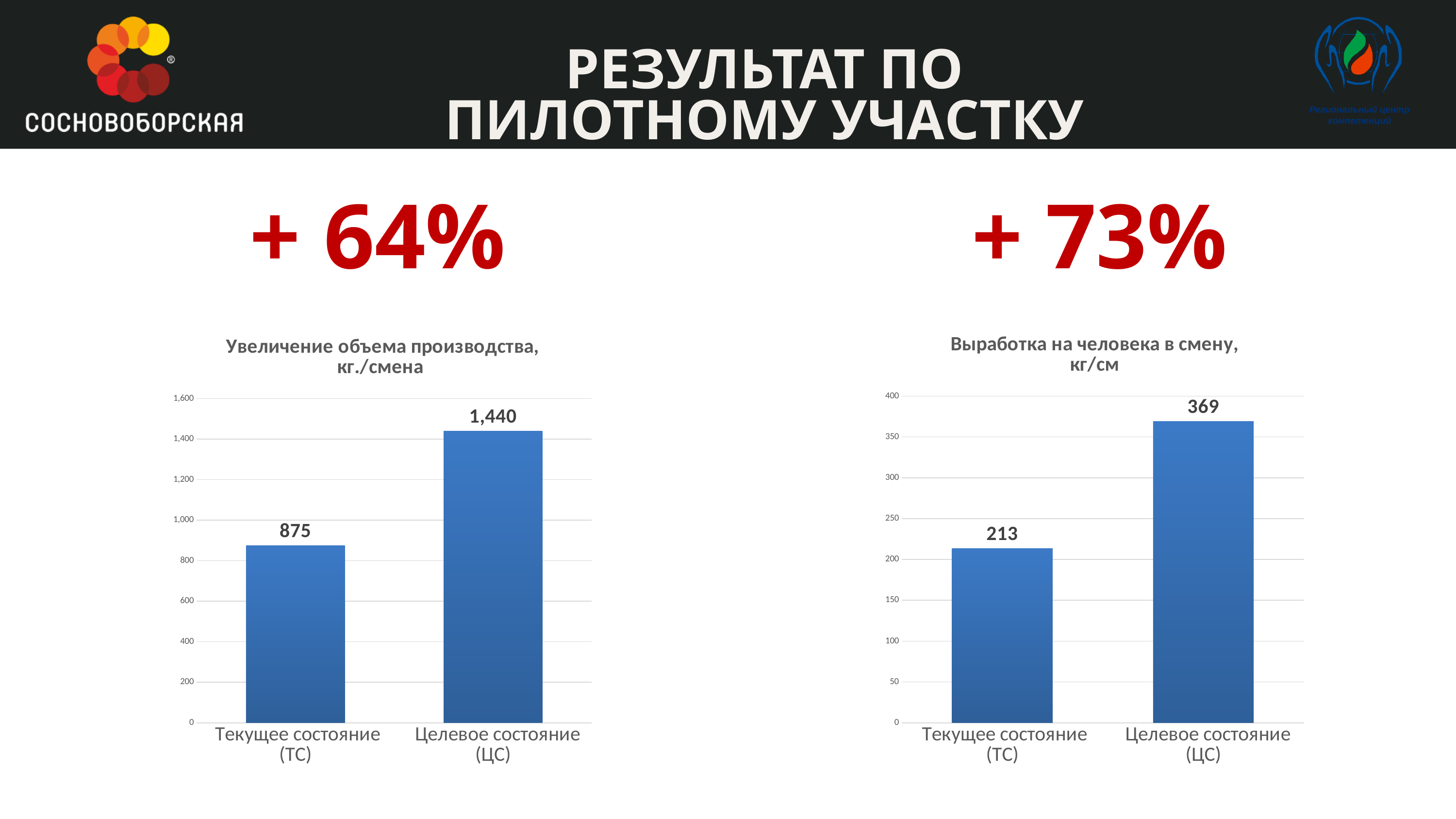
In the right chart (Выработка на человека в смену, кг/см), what is the difference between Целевое состояние (ЦС) and Текущее состояние (ТС)? 156 What type of chart is the right chart (Выработка на человека в смену, кг/см)? bar chart In the left chart (Увеличение объема производства, кг./смена), how many categories are shown? 2 In the left chart (Увеличение объема производства, кг./смена), what is the difference between Целевое состояние (ЦС) and Текущее состояние (ТС)? 565 In the right chart (Выработка на человека в смену, кг/см), is the value for Текущее состояние (ТС) greater or less than 250? less In the left chart (Увеличение объема производства, кг./смена), what is the value for Текущее состояние (ТС)? 875 In the right chart (Выработка на человека в смену, кг/см), what is the value for Текущее состояние (ТС)? 213 In the right chart (Выработка на человека в смену, кг/см), what is the value for Целевое состояние (ЦС)? 369 In the left chart (Увеличение объема производства, кг./смена), what is the value for Целевое состояние (ЦС)? 1,440 In the right chart (Выработка на человека в смену, кг/см), which category has the lowest value? Текущее состояние (ТС) In the left chart (Увеличение объема производства, кг./смена), which category has the highest value? Целевое состояние (ЦС) What is the title of the left chart? Увеличение объема производства, кг./смена